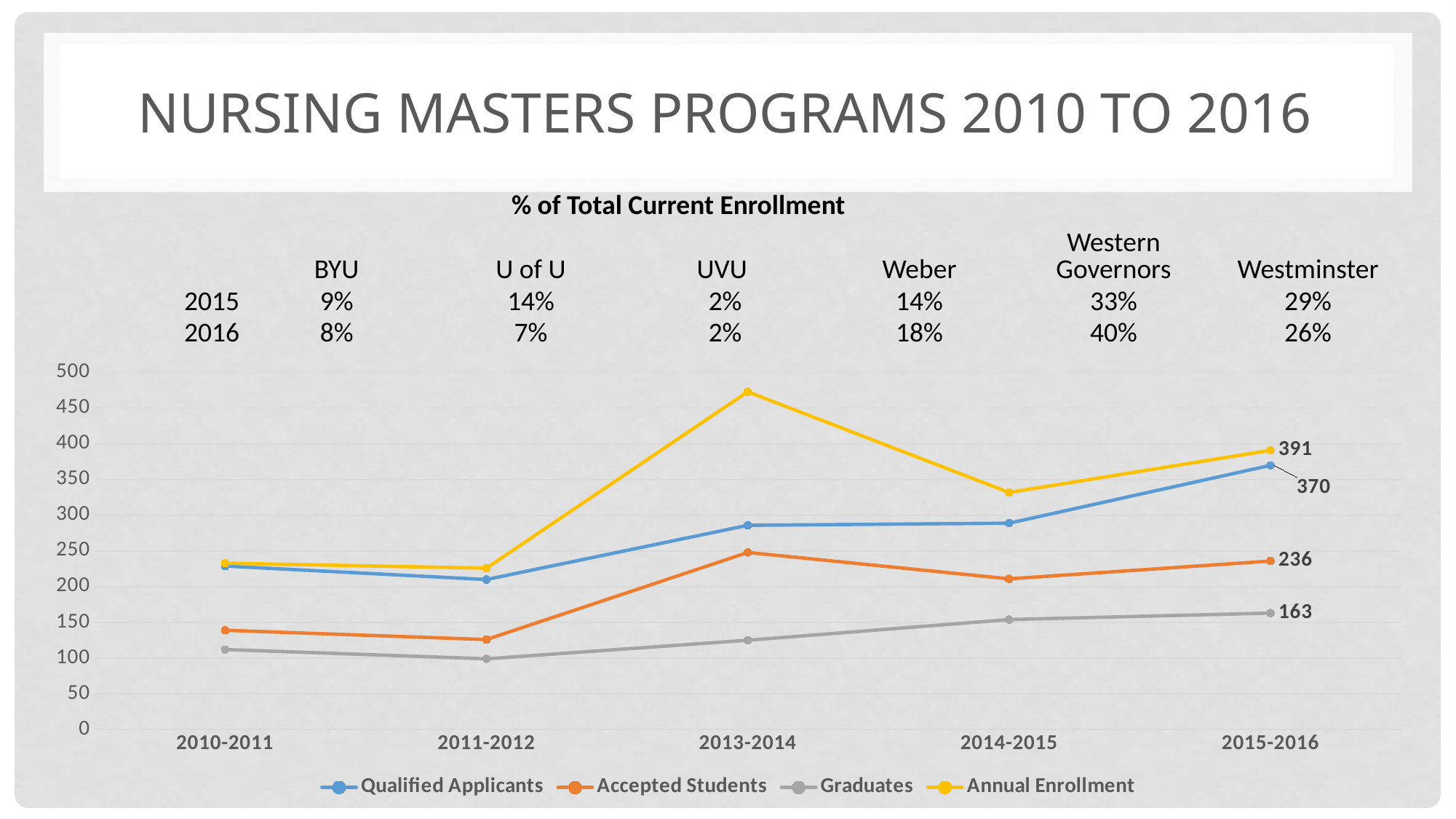
What kind of chart is shown on the slide? line chart What is the value for Qualified Applicants in 2015-2016? 370 How many series does the legend list? 4 What is the value for Graduates in 2015-2016? 163 What is the value for Annual Enrollment in 2015-2016? 391 Which series has the highest value in 2013-2014? Annual Enrollment What is the value for Accepted Students in 2015-2016? 236 Do the Graduates values rise or fall from 2011-2012 to 2015-2016? rise Is the value for Annual Enrollment in 2013-2014 greater or less than 450? greater Which series has the lowest value in 2015-2016? Graduates What is the difference between Accepted Students and Graduates in 2015-2016? 73 What is the difference between Annual Enrollment and Qualified Applicants in 2015-2016? 21